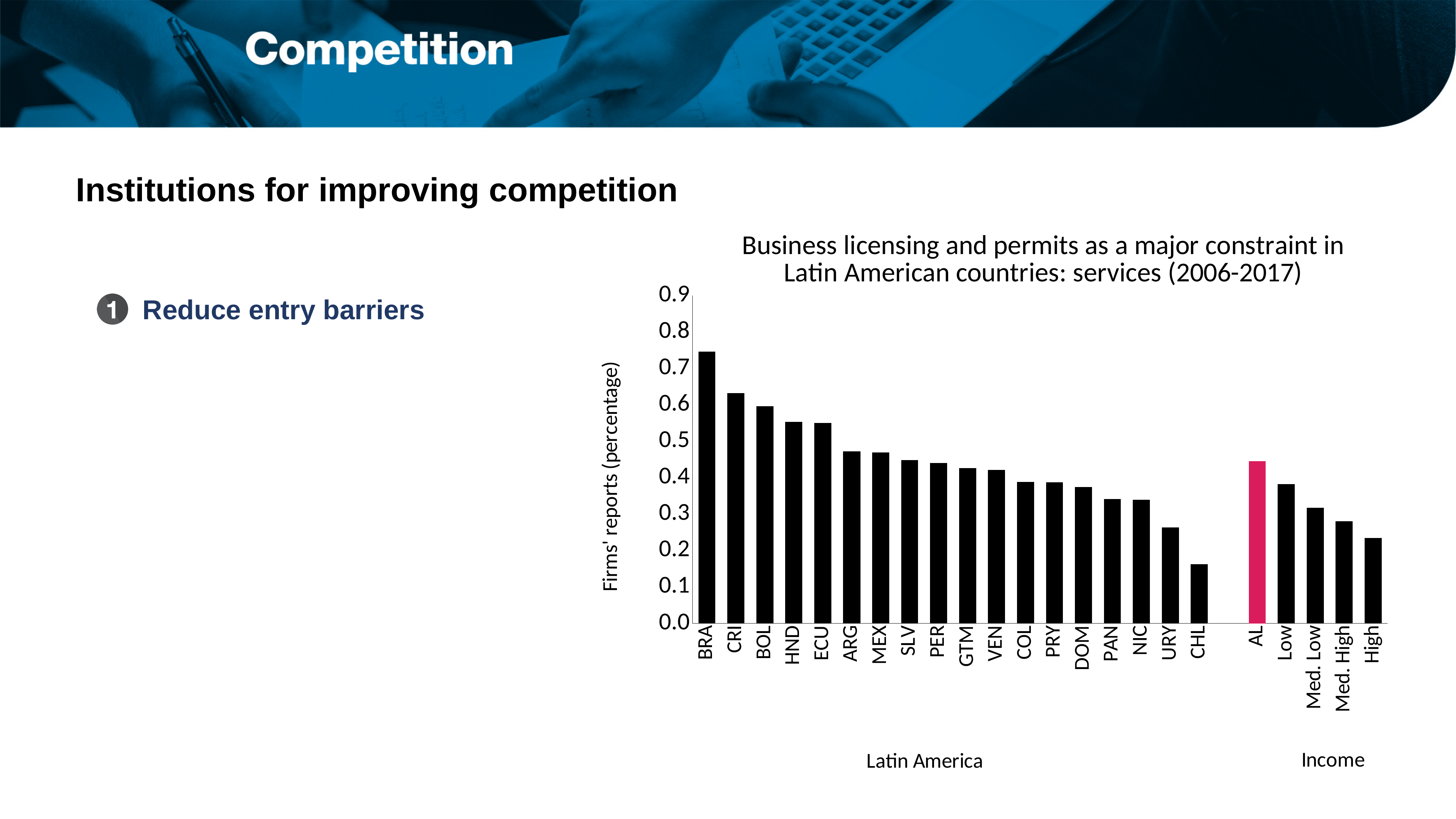
Which country has the lowest value in the chart? CHL Is the value for BRA greater or less than 0.7? greater Is the value for High greater or less than 0.3? less Do the values for the Latin American countries rise or fall from left to right along the x axis? fall Which country has the highest value in the chart? BRA What kind of chart is shown on the slide? bar chart Which is larger, the value for BRA or the value for CRI? BRA What is the label of the y axis? Firms' reports (percentage) Is the value for CHL greater or less than 0.2? less Which is larger, the value for Low or the value for High? Low How many bars are plotted in the chart in total? 23